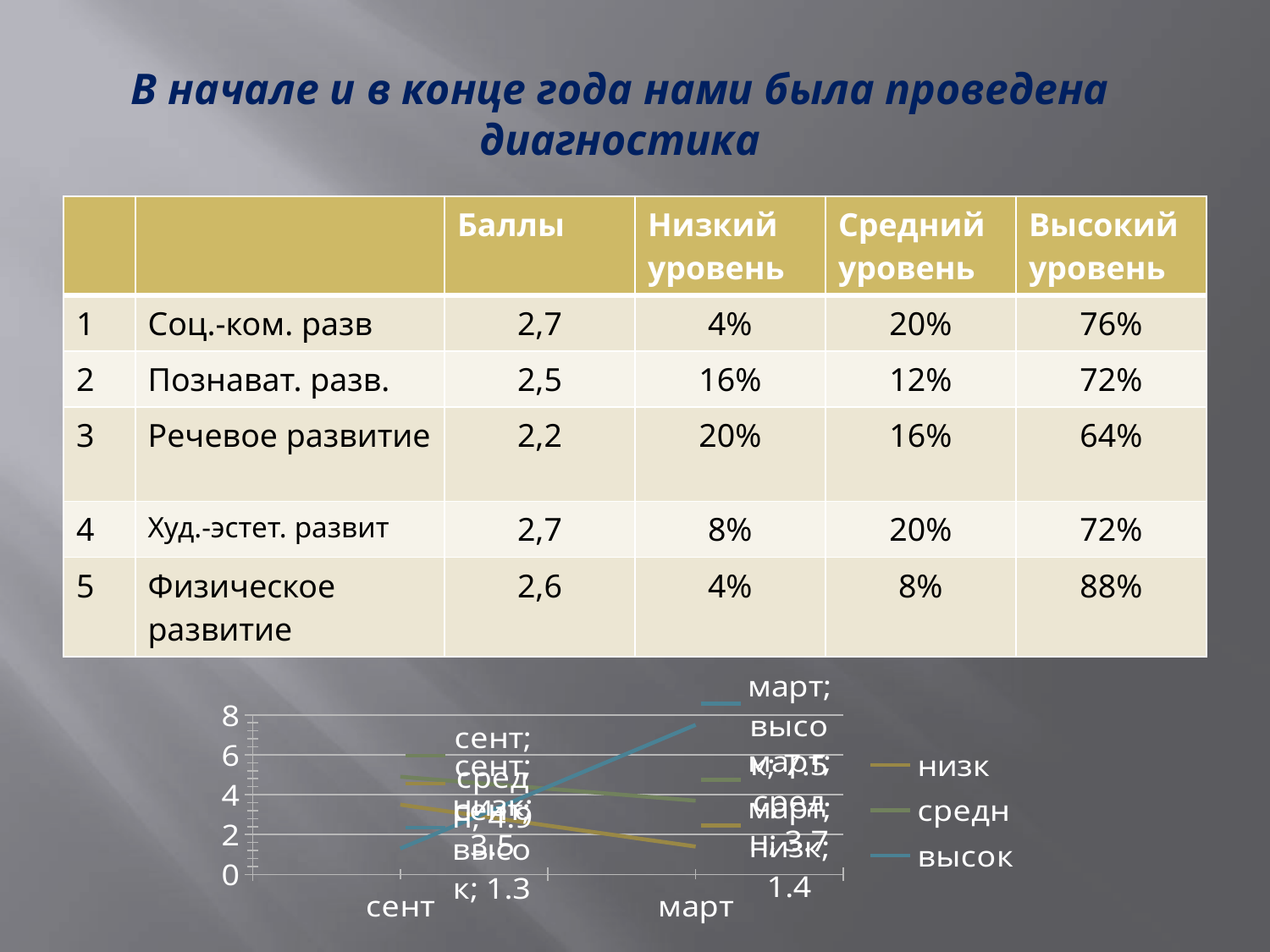
How many categories are on the x axis of the line chart? 2 In the line chart, does the высок series rise or fall from сент to март? rises What are the two categories on the x axis of the line chart? сент, март In the line chart, does the низк series rise or fall from сент to март? falls In the line chart, what is the value of the высок series for март? 7.5 What kind of chart is shown at the bottom of the slide? line chart In the line chart, what is the value of the высок series for сент? 1.3 In the line chart, which series has the lowest value for март? низк In the line chart, is the value of the высок series for март greater or less than 6? greater In the line chart, which series has the highest value for март? высок In the line chart, what is the value of the низк series for март? 1.4 How many series does the legend of the line chart list? 3